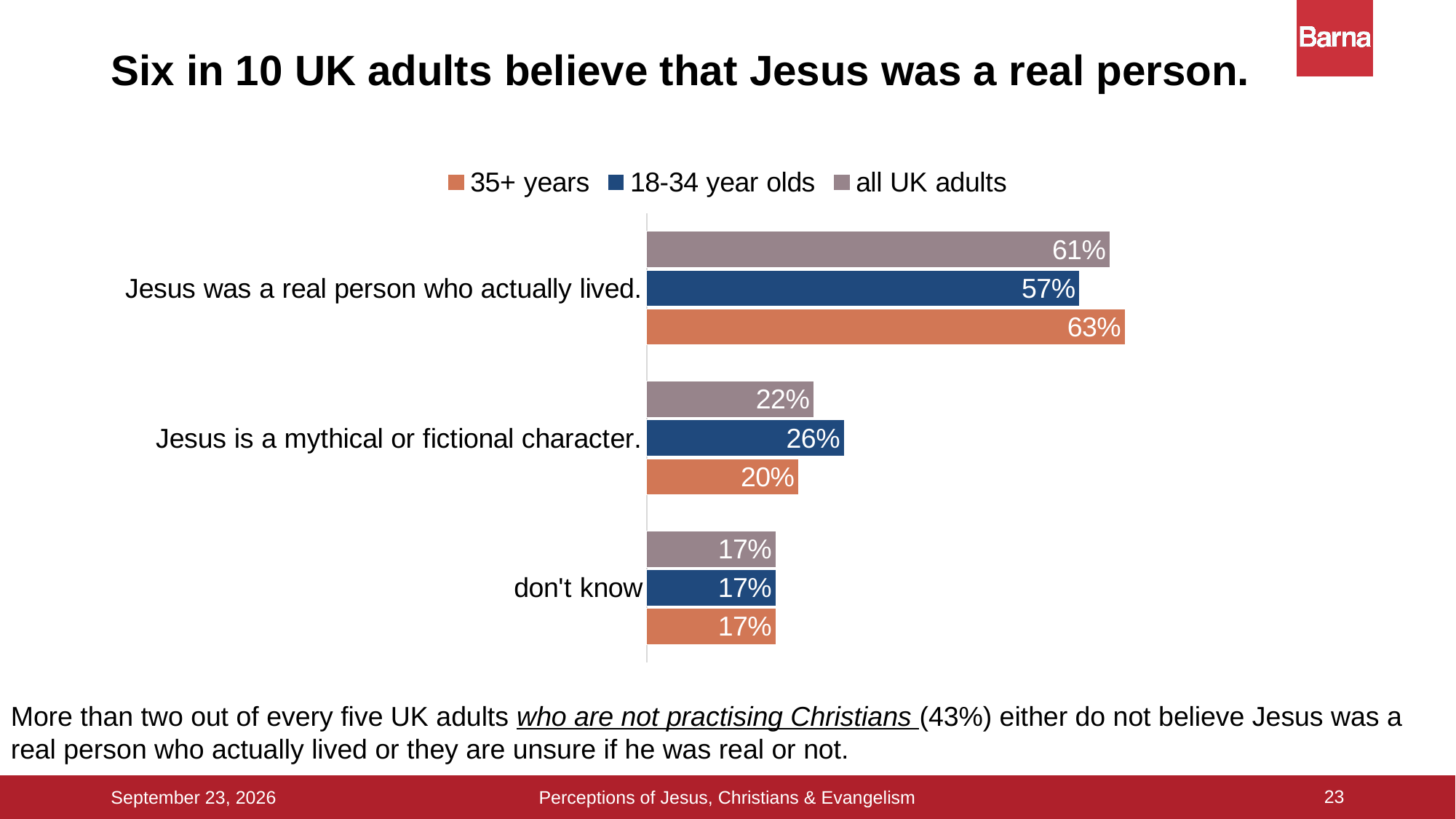
Which is larger for 'Jesus is a mythical or fictional character': 18-34 year olds or all UK adults? 18-34 year olds What percentage of 18-34 year olds say Jesus is a mythical or fictional character? 26% Which age group has the lowest value for 'Jesus is a mythical or fictional character'? 35+ years What percentage of all UK adults say Jesus was a real person who actually lived? 61% What kind of chart is shown on the slide? Bar chart What percentage of 35+ years respondents say Jesus was a real person who actually lived? 63% Which age group has the highest value for 'Jesus was a real person who actually lived'? 35+ years What is the difference between the 18-34 year olds and all UK adults values for 'Jesus is a mythical or fictional character'? 4 percentage points How many response categories are shown on the chart? 3 How many series does the legend list? 3 What percentage of 35+ years respondents answered 'don't know'? 17% What is the difference between the 35+ years and 18-34 year olds values for 'Jesus was a real person who actually lived'? 6 percentage points